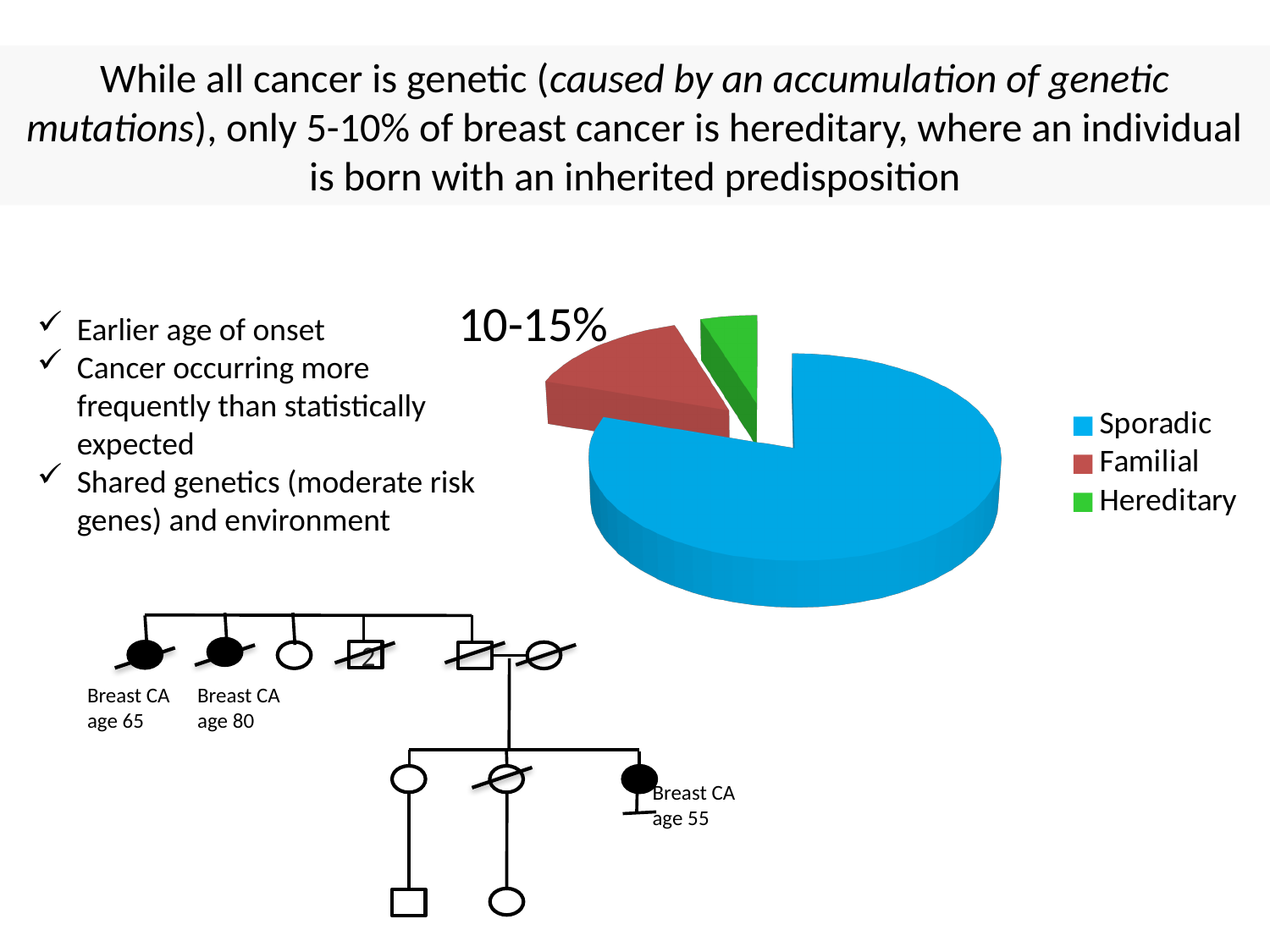
Which category has the smallest slice of the pie chart? Hereditary What kind of chart is shown on the slide? pie chart How many slices does the pie chart have? 3 Which category has the largest slice of the pie chart? Sporadic Which category is shown in green in the pie chart? Hereditary How many entries does the pie chart's legend list? 3 Which slice is larger in the pie chart, Familial or Hereditary? Familial What colour is the Sporadic slice in the pie chart? blue Which slice is larger in the pie chart, Sporadic or Familial? Sporadic